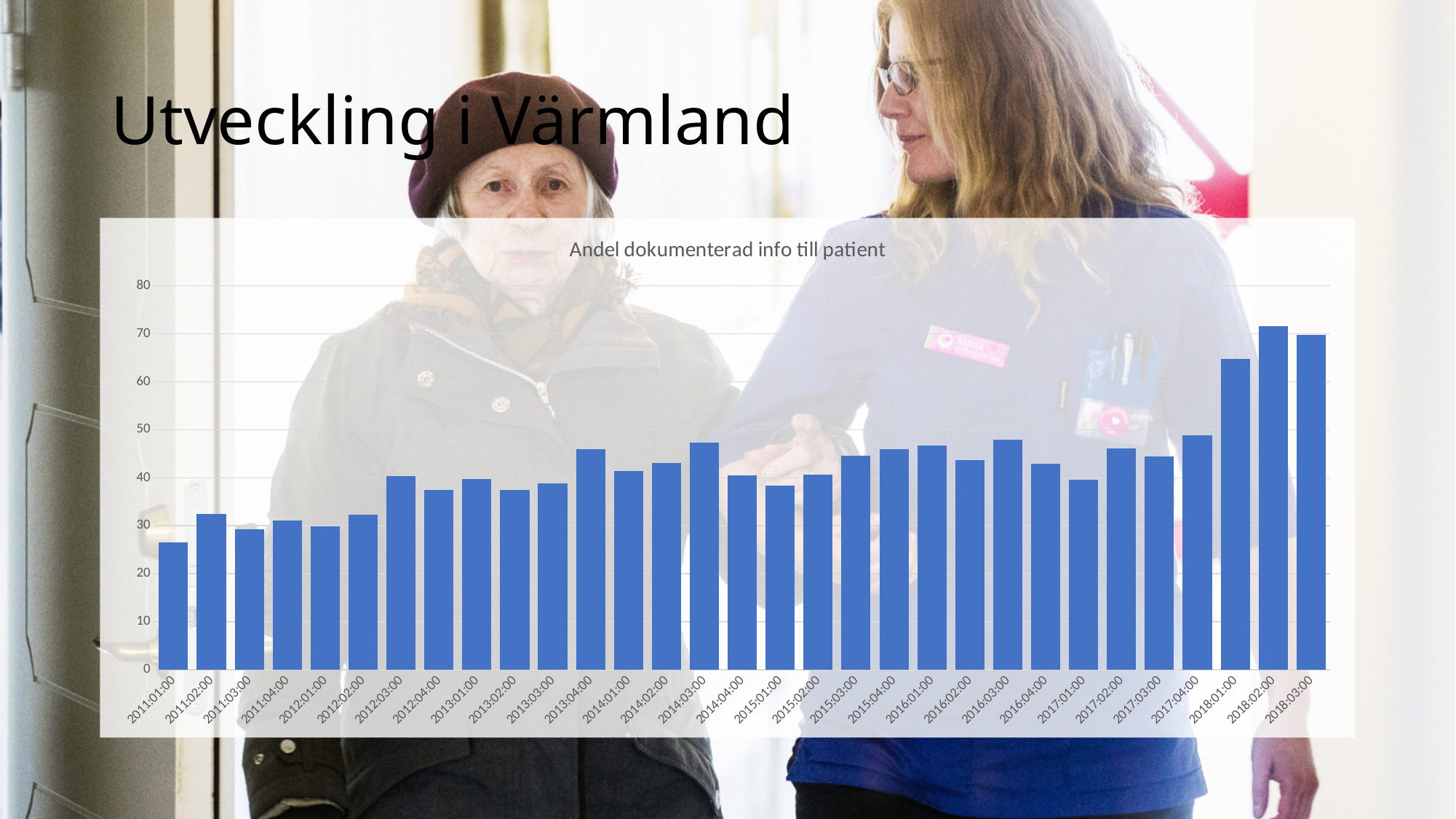
Which is larger, the value for 2011:01:00 or the value for 2011:02:00? 2011:02:00 What kind of chart is shown on the slide? bar chart Is the value for 2018:01:00 greater or less than 60? greater Overall, do the values rise or fall from 2011:01:00 to 2018:03:00? rise Is the value for 2014:03:00 greater or less than 40? greater Is the value for 2011:01:00 greater or less than 30? less Which is larger, the value for 2018:01:00 or the value for 2017:04:00? 2018:01:00 Which category has the lowest value in the chart? 2011:01:00 Which category has the highest value in the chart? 2018:02:00 How many bars (categories) are plotted in the chart? 31 What is the title of the chart? Andel dokumenterad info till patient